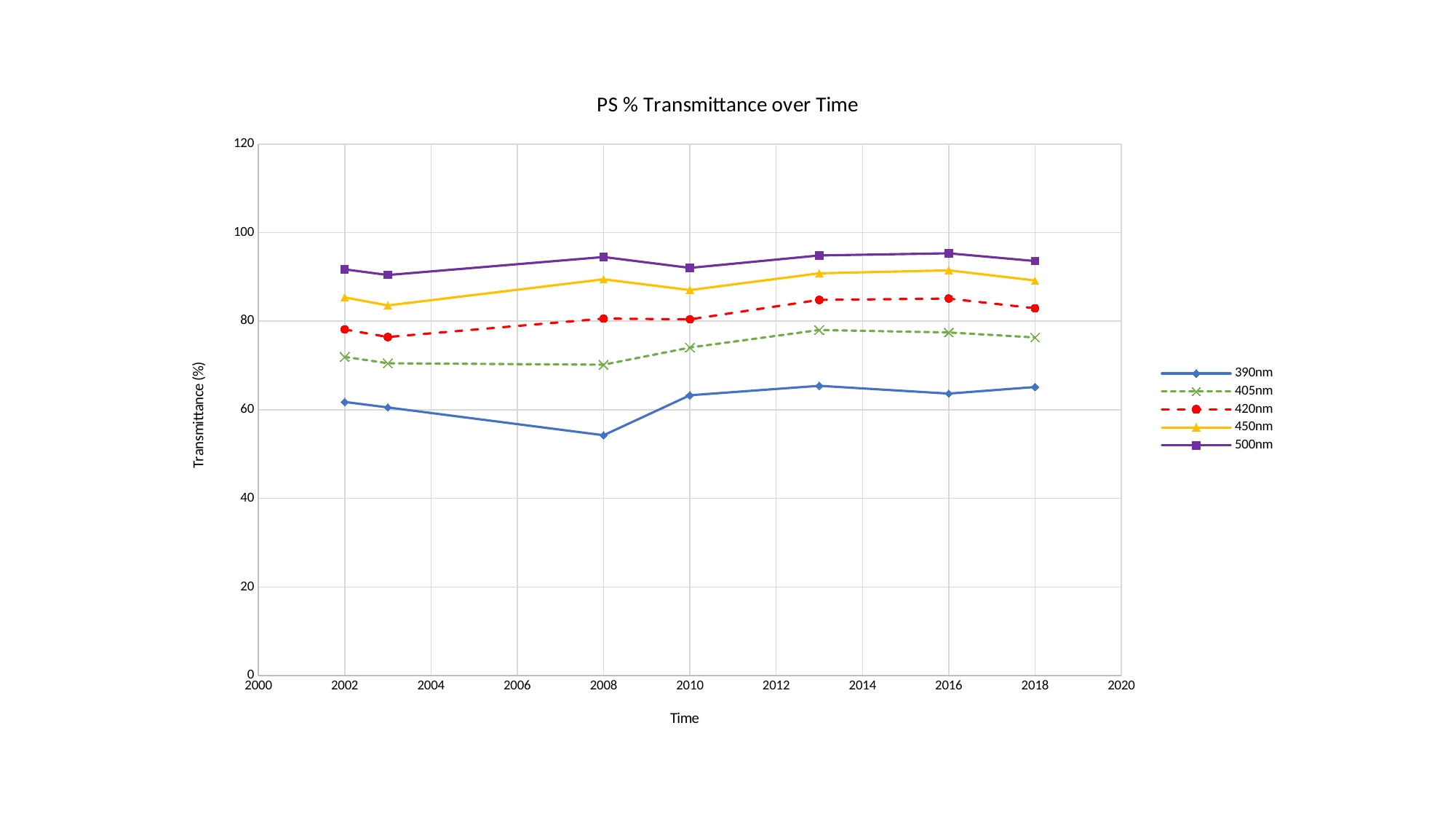
In which year does the 390nm series reach its lowest value? 2008 Which series has the highest transmittance values across the chart? 500nm Is the value for 405nm in 2002 greater or less than 60? greater How many data points are plotted for the 390nm series? 7 How many series does the legend list? 5 What is the title of the chart? PS % Transmittance over Time Does the 390nm series rise or fall between 2002 and 2008? fall Which series has the lowest transmittance values across the chart? 390nm Is the value for 500nm in 2016 greater or less than 80? greater Is the value for 390nm in 2008 greater or less than 60? less What kind of chart is shown on the slide? line chart Which is larger for the 390nm series: the value in 2008 or the value in 2010? 2010